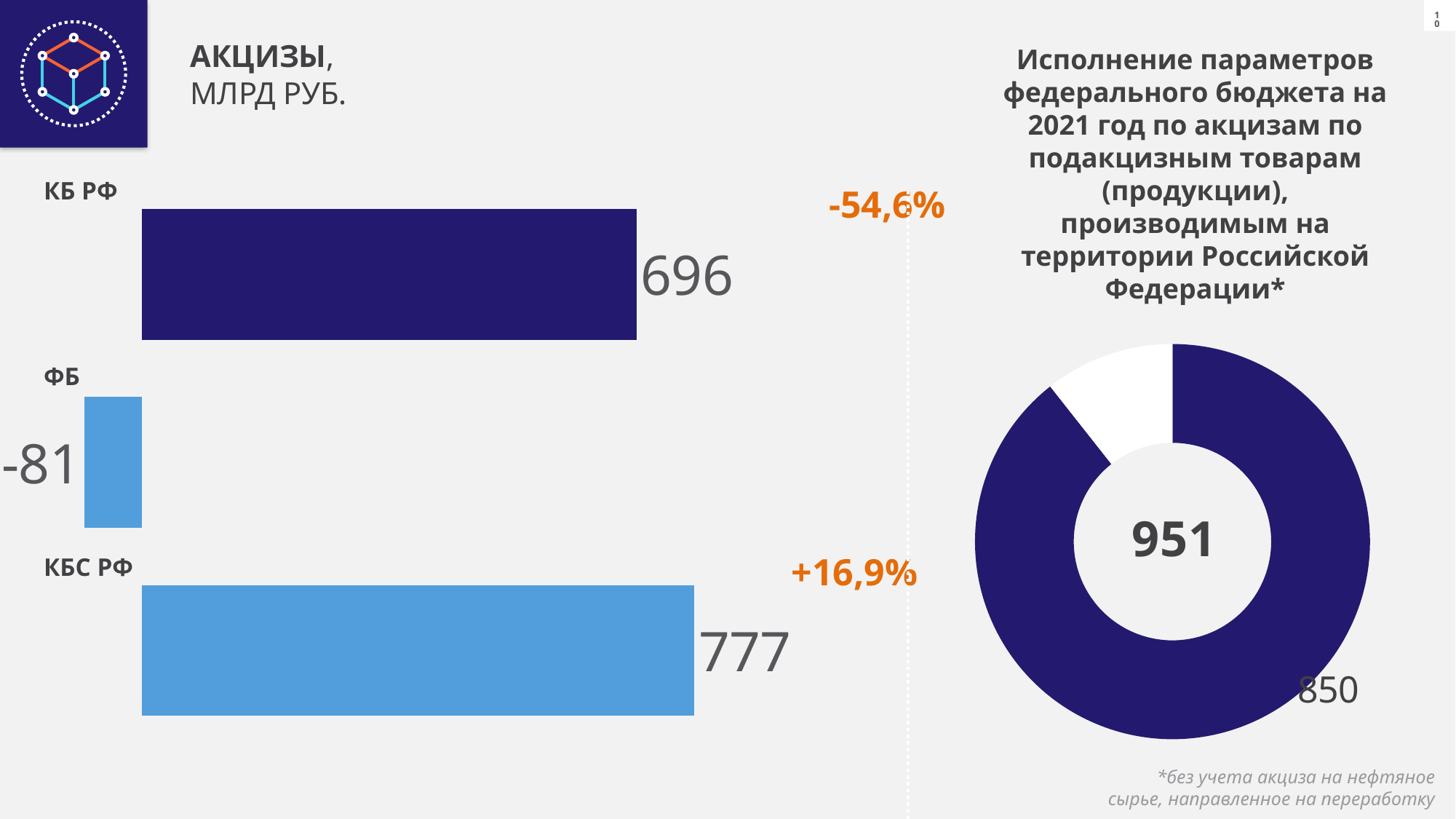
On the bar chart "АКЦИЗЫ, МЛРД РУБ.", what is the value for ФБ? -81 On the bar chart "АКЦИЗЫ, МЛРД РУБ.", what is the value for КБ РФ? 696 On the bar chart "АКЦИЗЫ, МЛРД РУБ.", what is the difference between the values for КБС РФ and КБ РФ? 81 On the bar chart "АКЦИЗЫ, МЛРД РУБ.", what is the value for КБС РФ? 777 What kind of chart is the chart on the right of the slide? doughnut chart On the bar chart "АКЦИЗЫ, МЛРД РУБ.", which category has the lowest value? ФБ On the bar chart "АКЦИЗЫ, МЛРД РУБ.", which category has the highest value? КБС РФ On the bar chart "АКЦИЗЫ, МЛРД РУБ.", which is larger, the value for КБ РФ or the value for КБС РФ? КБС РФ What kind of chart is the chart on the left of the slide titled "АКЦИЗЫ, МЛРД РУБ."? bar chart On the doughnut chart on the right of the slide, what number is shown in the centre? 951 On the doughnut chart on the right of the slide, what value is labelled on the dark blue segment? 850 How many categories are shown on the bar chart "АКЦИЗЫ, МЛРД РУБ."? 3